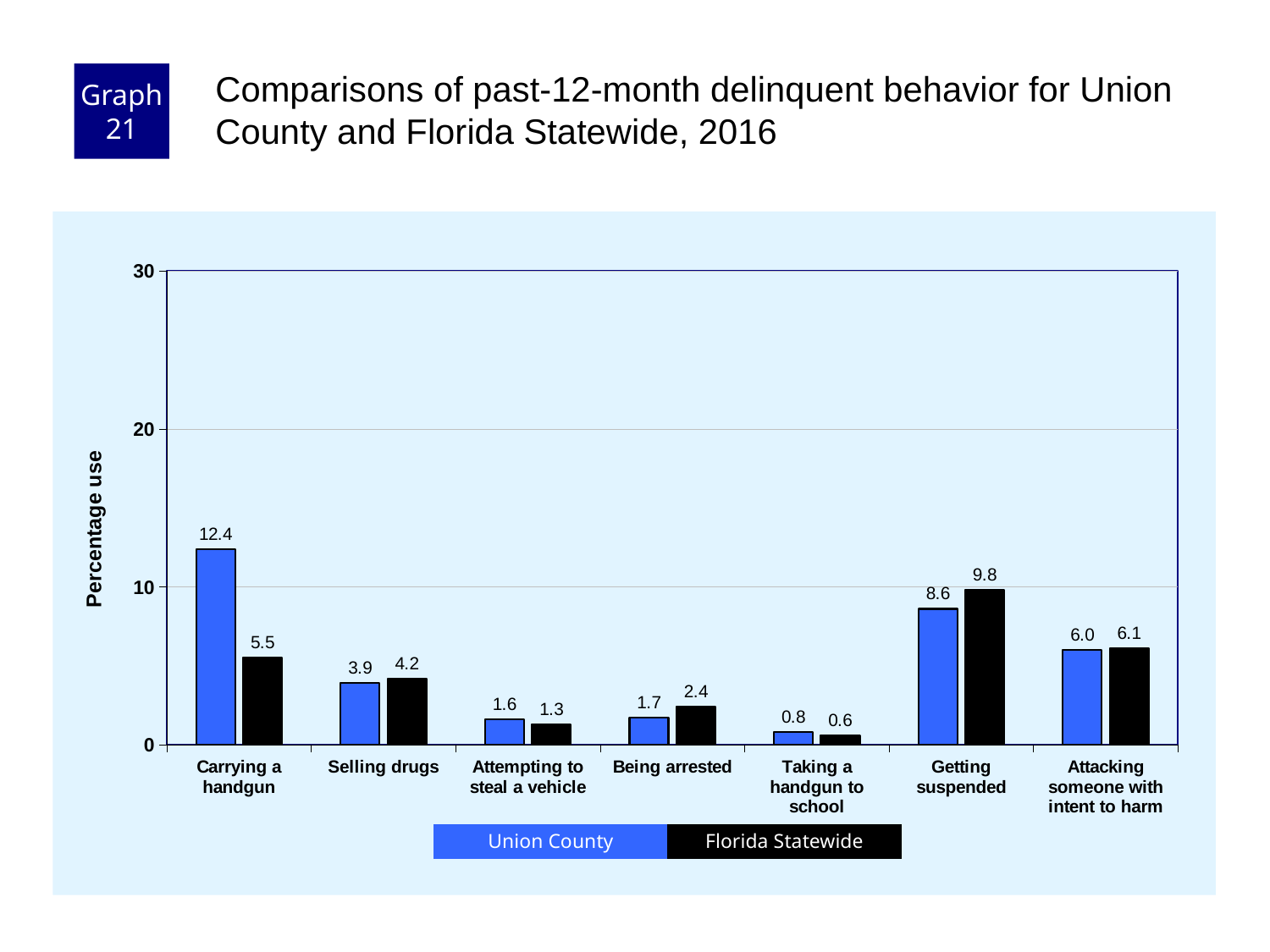
What is the Union County value for Taking a handgun to school? 0.8 What is the Union County value for Carrying a handgun? 12.4 What is the label of the y axis? Percentage use Is the Union County value for Carrying a handgun greater or less than 10? greater What is the Florida Statewide value for Getting suspended? 9.8 How many behavior categories are shown on the x axis? 7 Which category has the highest Union County value? Carrying a handgun Which is larger for Being arrested, the Union County value or the Florida Statewide value? Florida Statewide Which category has the lowest Florida Statewide value? Taking a handgun to school What kind of chart is shown on the slide? Bar chart How many series does the legend list? 2 What is the difference between the Union County and Florida Statewide values for Carrying a handgun? 6.9